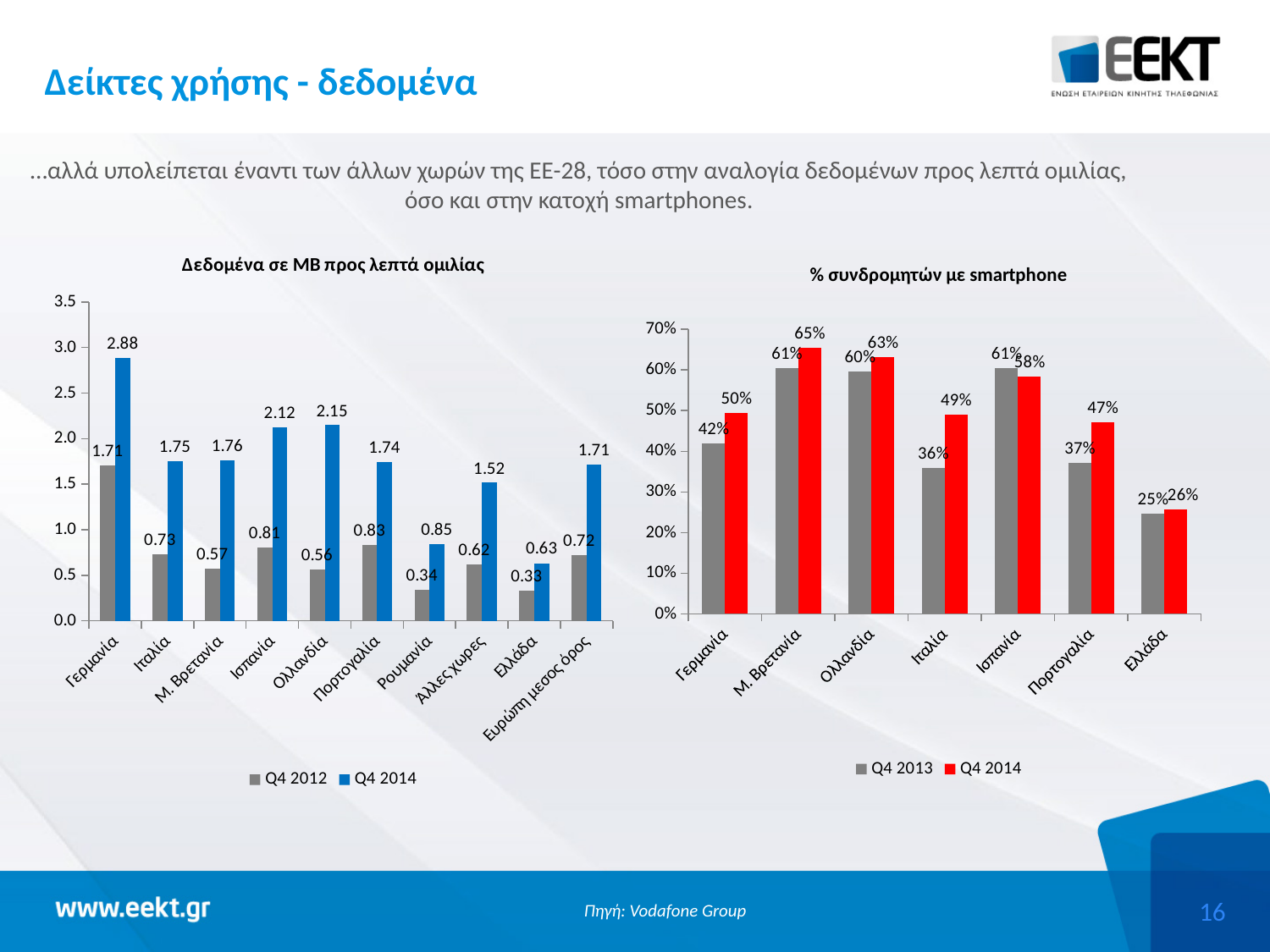
In the chart '% συνδρομητών με smartphone', what is the Q4 2014 value for Ιταλία? 49% In the chart 'Δεδομένα σε MB προς λεπτά ομιλίας', which category has the lowest Q4 2012 value? Ελλάδα What kind of chart is '% συνδρομητών με smartphone'? Bar chart In the chart '% συνδρομητών με smartphone', what is the difference between the Q4 2014 and Q4 2013 values for Πορτογαλία? 10% In the chart 'Δεδομένα σε MB προς λεπτά ομιλίας', how many categories are shown on the x axis? 10 In the chart 'Δεδομένα σε MB προς λεπτά ομιλίας', what is the Q4 2012 value for Ελλάδα? 0.33 In the chart 'Δεδομένα σε MB προς λεπτά ομιλίας', what is the difference between the Q4 2014 and Q4 2012 values for Ολλανδία? 1.59 In the chart 'Δεδομένα σε MB προς λεπτά ομιλίας', what is the Q4 2014 value for Γερμανία? 2.88 In the chart '% συνδρομητών με smartphone', which is larger for Ισπανία: the Q4 2013 value or the Q4 2014 value? Q4 2013 In the chart '% συνδρομητών με smartphone', which category has the highest Q4 2014 value? Μ. Βρετανία In the chart 'Δεδομένα σε MB προς λεπτά ομιλίας', which category has the highest Q4 2014 value? Γερμανία In the chart 'Δεδομένα σε MB προς λεπτά ομιλίας', which series does the legend list? Q4 2012 and Q4 2014